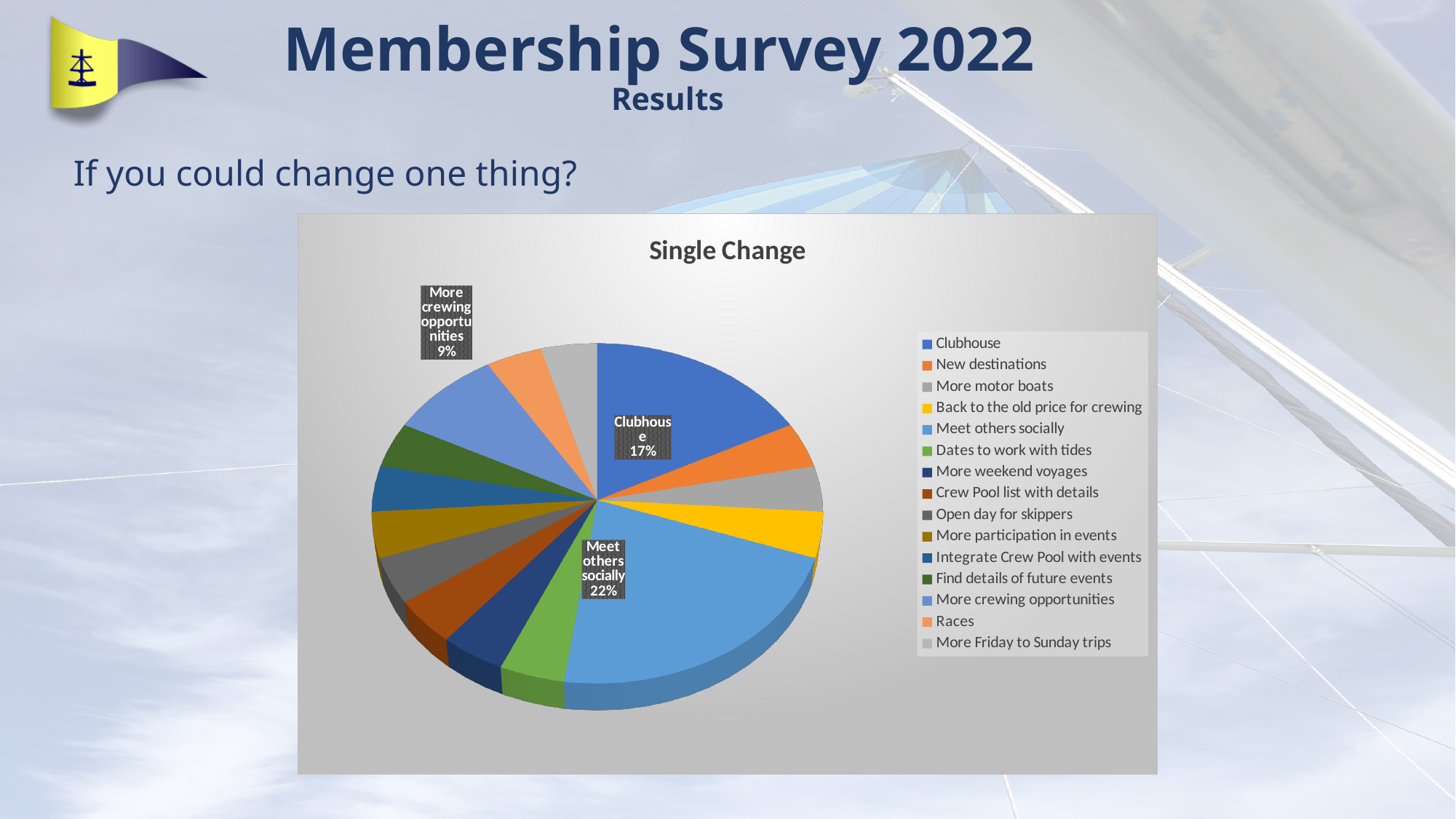
What percentage of the pie is labelled for Meet others socially? 22% Which is larger, the Clubhouse slice or the More crewing opportunities slice? Clubhouse Which category has the largest slice of the pie? Meet others socially How many categories are listed in the chart's legend? 15 What is the difference in percentage points between the Meet others socially slice and the Clubhouse slice? 5% What percentage of the pie is labelled for More crewing opportunities? 9% What colour is the Clubhouse slice in the pie chart? Blue What is the difference in percentage points between the Clubhouse slice and the More crewing opportunities slice? 8% What kind of chart is shown on the slide? Pie chart What percentage of the pie is labelled for Clubhouse? 17% What is the title of the chart? Single Change Which is larger, the Clubhouse slice or the Meet others socially slice? Meet others socially